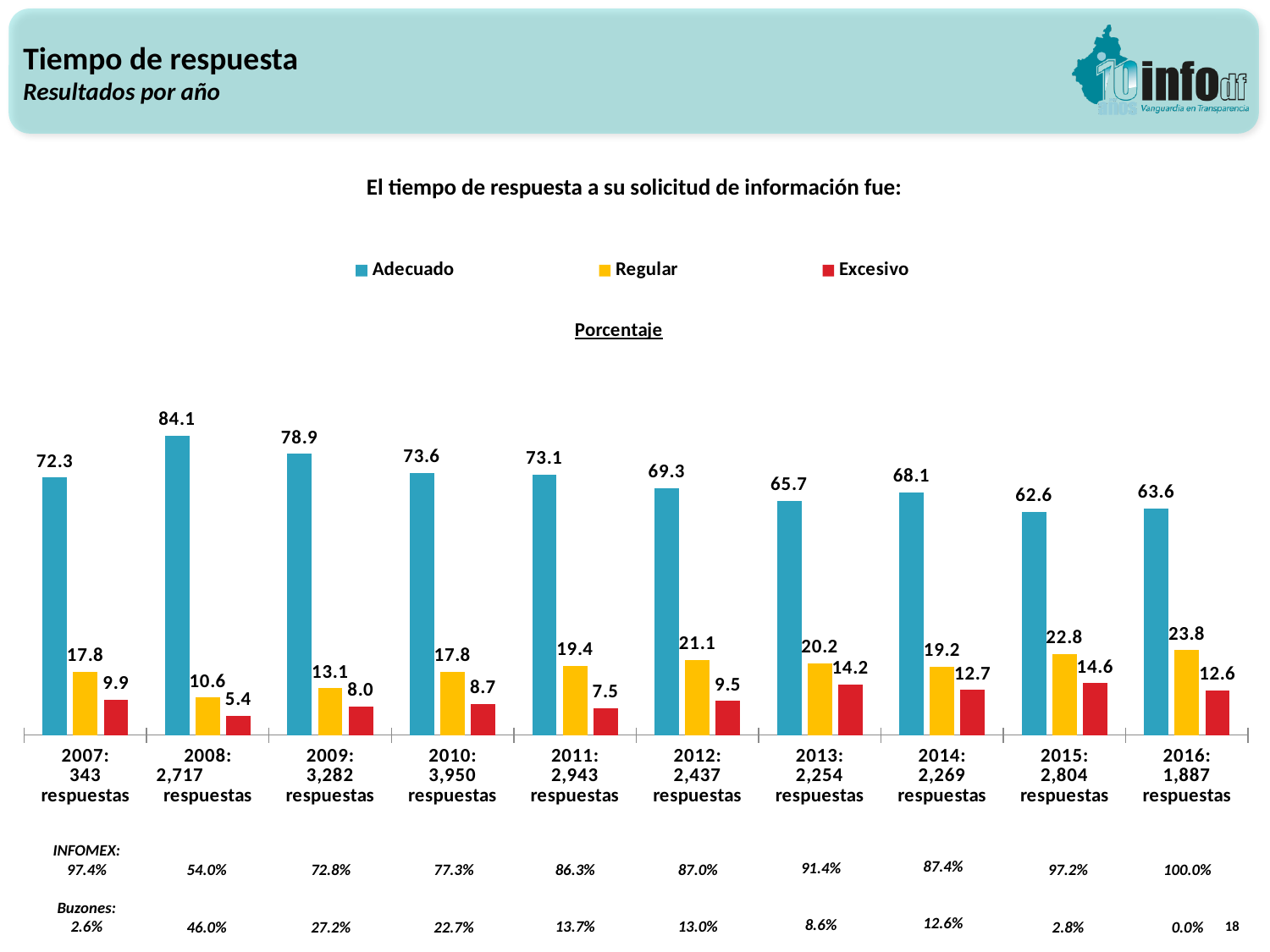
Which year has the highest Adecuado value? 2008 What is the difference between the Adecuado values for 2008 and 2016? 20.5 What is the Excesivo value for 2013? 14.2 What is the Regular value for 2016? 23.8 Which year has the lowest Excesivo value? 2008 Which is larger, the Regular value for 2012 or the Regular value for 2014? 2012 Does the Regular series rise or fall from 2013 to 2016? rise Which colour represents the Excesivo series? red How many series does the legend list? 3 What kind of chart is shown? bar chart How many years are shown on the x axis? 10 What is the Adecuado value for 2008? 84.1